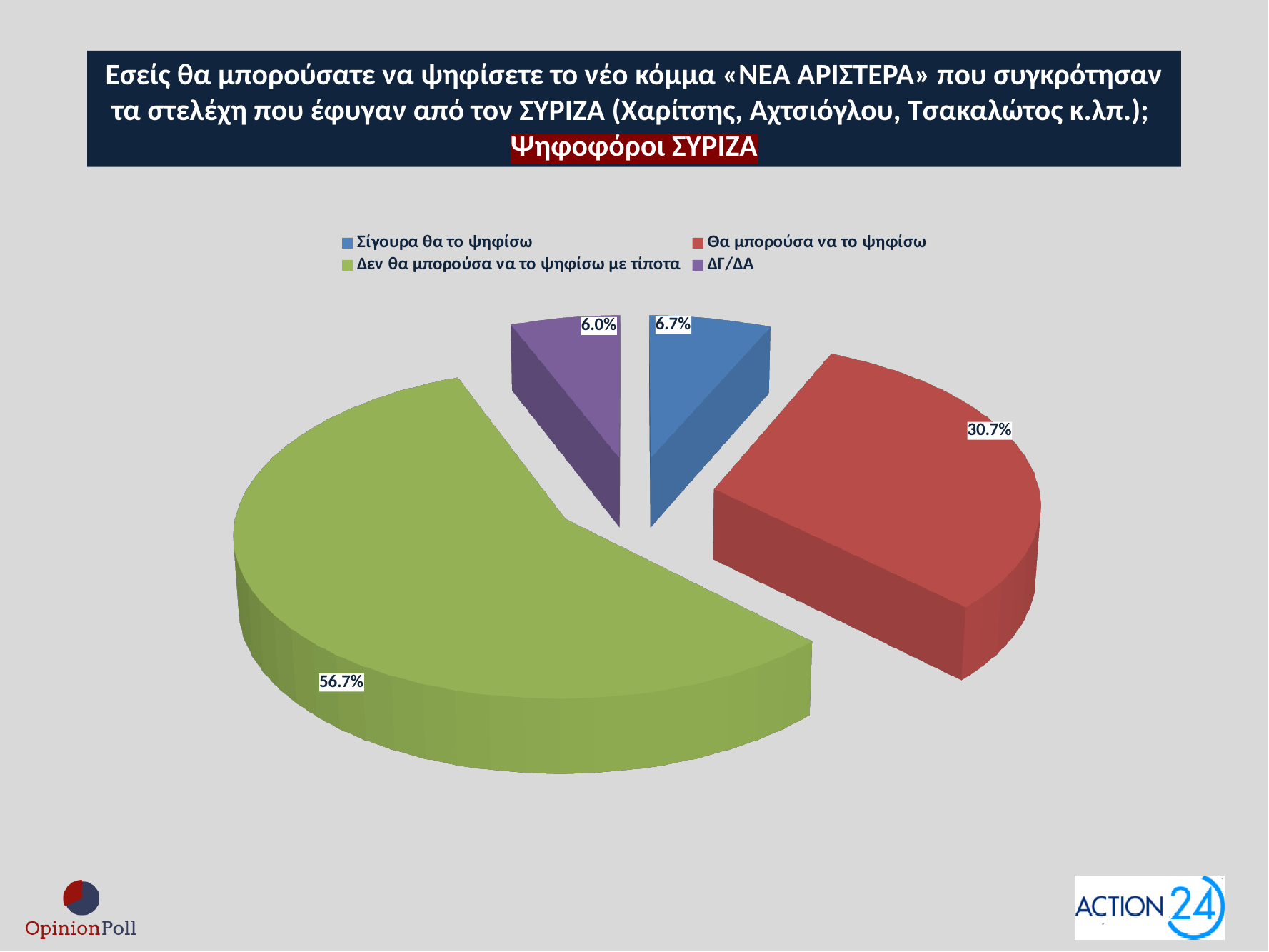
What percentage is shown for "Δεν θα μπορούσα να το ψηφίσω με τίποτα"? 56.7% What colour is the slice for "Θα μπορούσα να το ψηφίσω"? Red Which is larger: "Σίγουρα θα το ψηφίσω" or "Θα μπορούσα να το ψηφίσω"? Θα μπορούσα να το ψηφίσω How many slices does the pie chart have? 4 What percentage is shown for "Σίγουρα θα το ψηφίσω"? 6.7% What kind of chart is shown on the slide? Pie chart How many entries does the legend list? 4 What percentage is shown for "ΔΓ/ΔΑ"? 6.0% Which category has the largest share of the pie? Δεν θα μπορούσα να το ψηφίσω με τίποτα What percentage is shown for "Θα μπορούσα να το ψηφίσω"? 30.7% What is the difference in percentage points between "Δεν θα μπορούσα να το ψηφίσω με τίποτα" and "Θα μπορούσα να το ψηφίσω"? 26.0 Which category has the smallest share of the pie? ΔΓ/ΔΑ